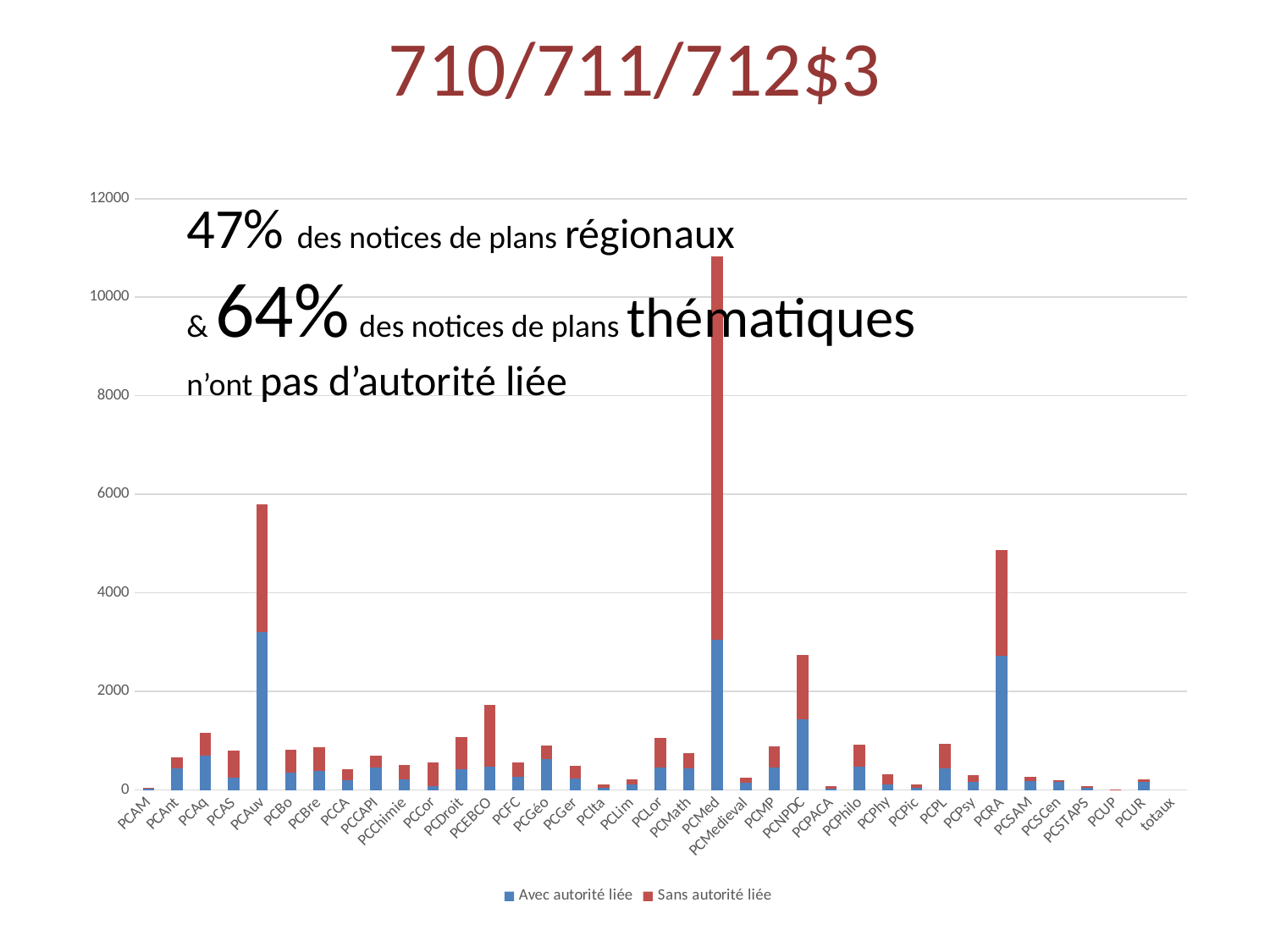
Which has the larger total bar, PCEBCO or PCNPDC? PCNPDC Which has the larger total bar, PCAuv or PCRA? PCAuv What is the highest value shown on the vertical axis of the chart? 12000 Which category has the highest total bar in the chart? PCMed Is the total value for PCRA greater or less than 4000? greater Is the total value for PCAuv greater or less than 6000? less What kind of chart is shown on the slide? Stacked bar chart What are the two series named in the chart legend? Avec autorité liée; Sans autorité liée Which colour represents the series 'Sans autorité liée' in the chart? Red Is the total value for PCNPDC greater or less than 2000? greater How many series does the chart legend list? 2